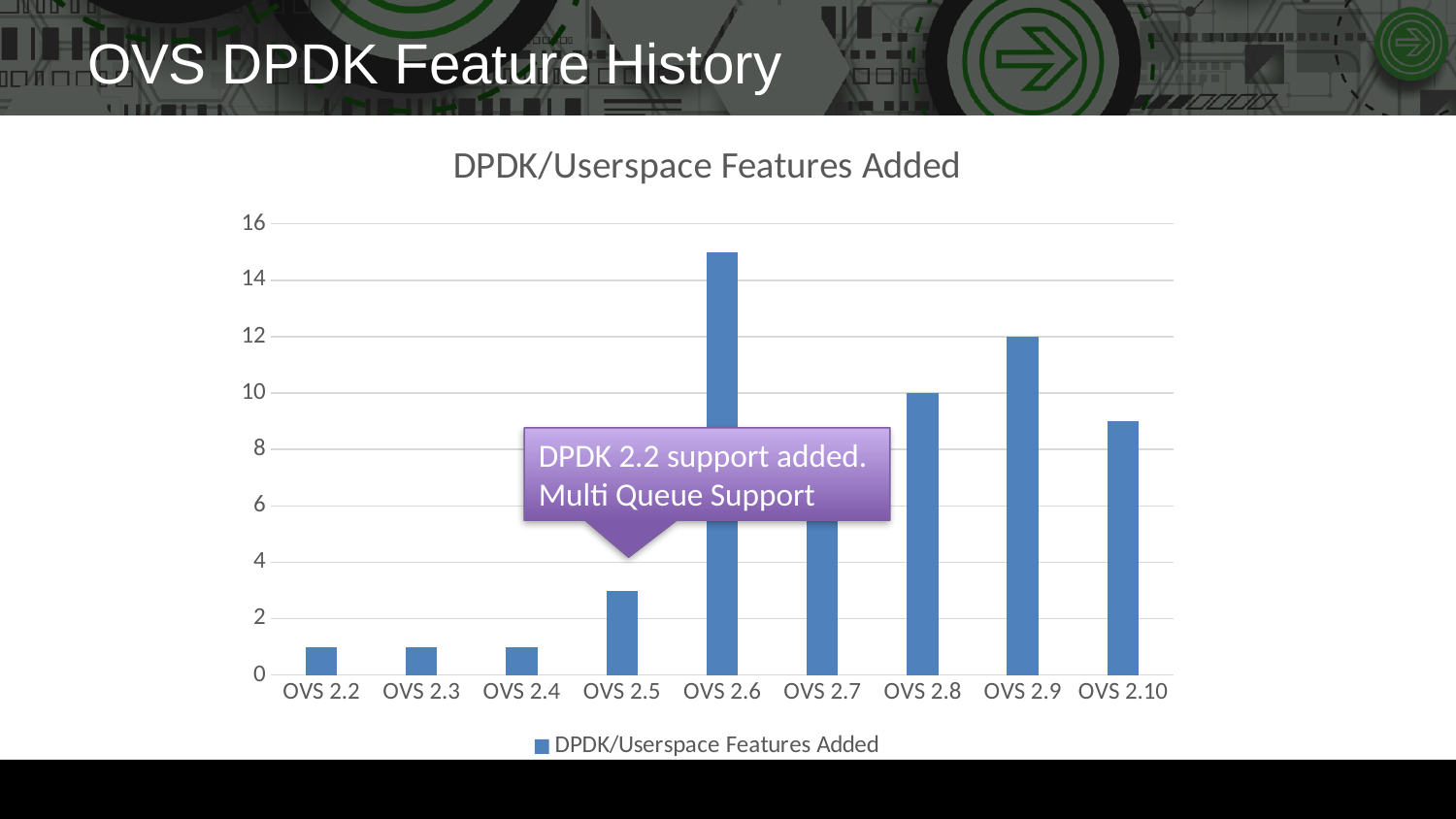
How many OVS versions (categories) are shown on the x axis? 9 Is the value for OVS 2.10 greater or less than 10? less Is the value for OVS 2.6 greater or less than 14? greater What is the difference between the values for OVS 2.9 and OVS 2.8? 2 Which OVS version has the highest number of DPDK/Userspace features added? OVS 2.6 How many series does the legend list? 1 Which is larger, the value for OVS 2.6 or the value for OVS 2.9? OVS 2.6 What type of chart is shown on the slide? bar chart What is the value for OVS 2.8? 10 What is the value for OVS 2.9? 12 Do the values generally rise or fall from OVS 2.2 to OVS 2.6? rise What is the title of the chart? DPDK/Userspace Features Added